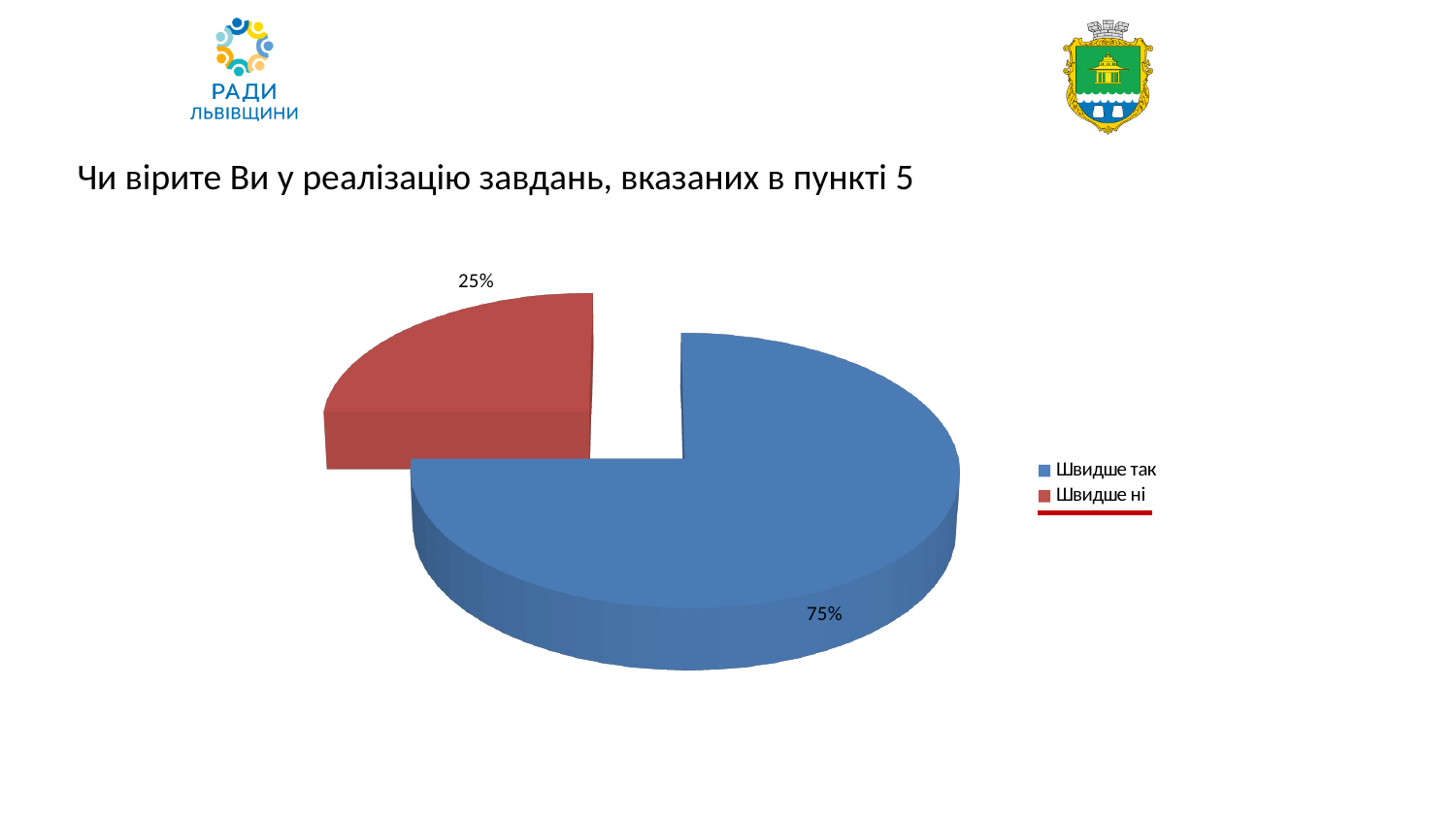
What is the difference in percentage points between "Швидше так" and "Швидше ні"? 50 What share of the pie does "Швидше так" represent? 75% How many slices does the pie chart have? 2 What question does the chart title ask? Чи вірите Ви у реалізацію завдань, вказаних в пункті 5 Which category has the largest slice of the pie? Швидше так What share of the pie does "Швидше ні" represent? 25% How many entries does the legend list? 2 Which is larger, the slice for "Швидше так" or the slice for "Швидше ні"? Швидше так Which category has the smallest slice of the pie? Швидше ні What kind of chart is shown on the slide? Pie chart What colour is the slice for "Швидше ні"? Red